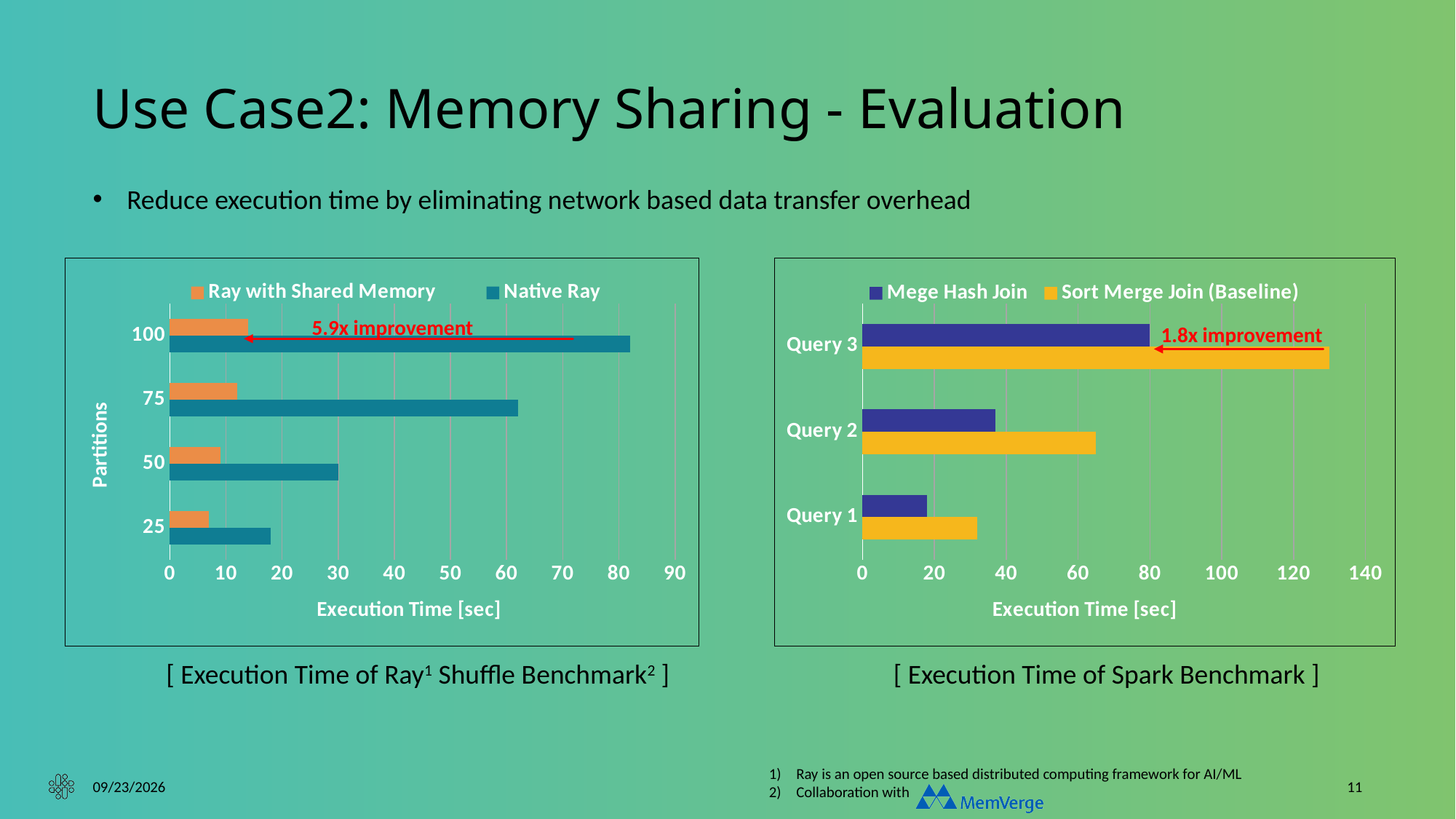
On the left chart (Ray Shuffle Benchmark), is the Native Ray value for 100 partitions greater or less than 80? greater On the left chart (Ray Shuffle Benchmark), which series has the larger execution time at 75 partitions, Ray with Shared Memory or Native Ray? Native Ray How many queries are shown on the right chart (Spark Benchmark)? 3 On the right chart (Spark Benchmark), which query has the lowest Mege Hash Join execution time? Query 1 What kind of chart is the Execution Time of Ray Shuffle Benchmark chart on the left? bar chart What kind of chart is the Execution Time of Spark Benchmark chart on the right? bar chart How many series does the legend of the left chart (Ray Shuffle Benchmark) list? 2 On the left chart (Ray Shuffle Benchmark), does the Native Ray execution time rise or fall as the number of partitions increases from 25 to 100? rise On the right chart (Spark Benchmark), is the Sort Merge Join (Baseline) value for Query 3 greater or less than 120? greater What improvement factor is annotated on the left chart (Ray Shuffle Benchmark)? 5.9x improvement On the left chart (Ray Shuffle Benchmark), at which number of partitions is the Native Ray execution time highest? 100 How many partition categories are shown on the left chart (Ray Shuffle Benchmark)? 4